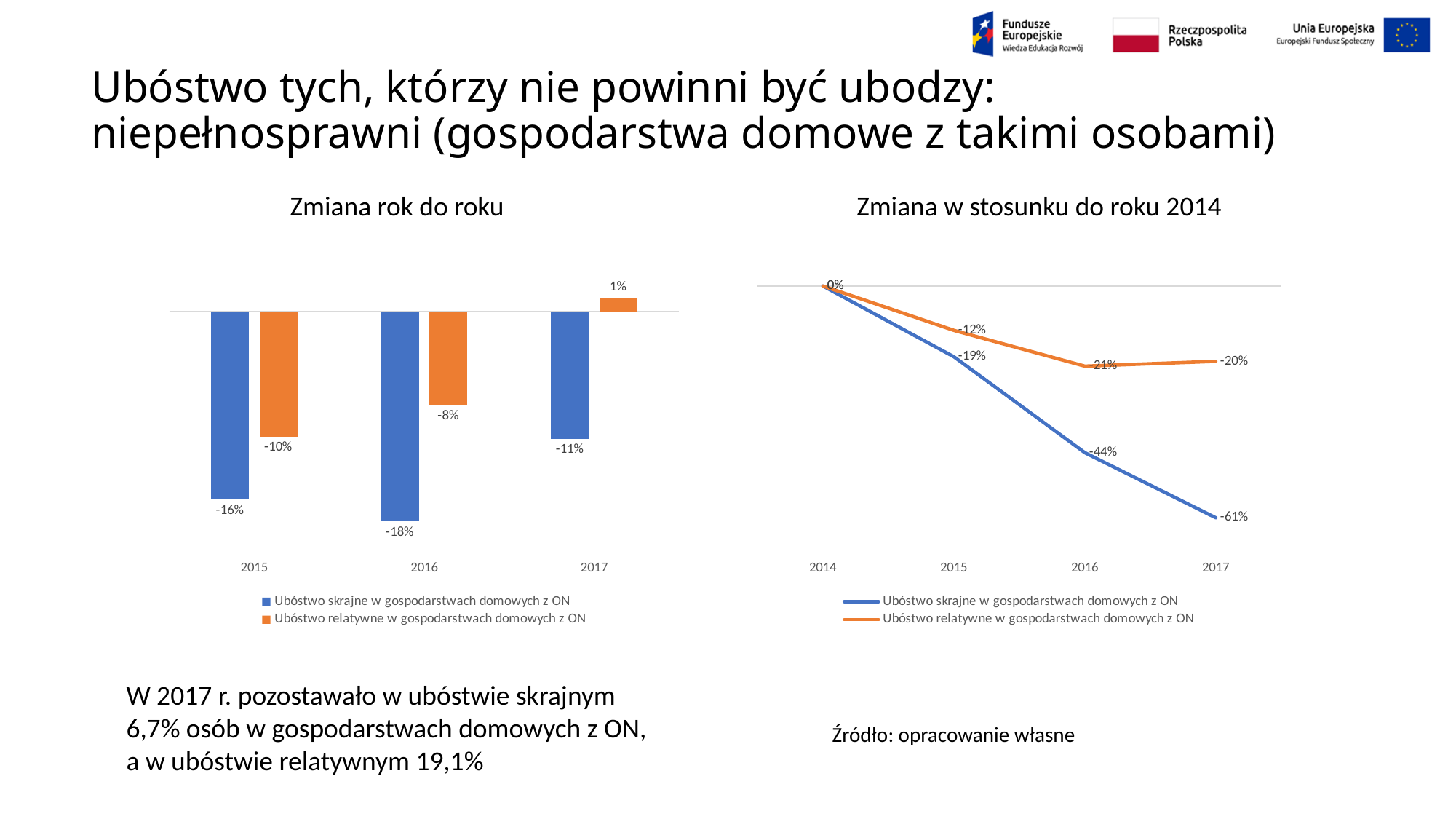
In the chart titled "Zmiana rok do roku", in which year is the value for Ubóstwo skrajne w gospodarstwach domowych z ON lowest? 2016 In the chart titled "Zmiana rok do roku", what is the value for Ubóstwo skrajne w gospodarstwach domowych z ON in 2016? -18% In the chart titled "Zmiana w stosunku do roku 2014", does the Ubóstwo skrajne series rise or fall from 2014 to 2017? Fall What kind of chart is the chart titled "Zmiana w stosunku do roku 2014"? Line chart In the chart titled "Zmiana rok do roku", how many years are shown on the x axis? 3 What kind of chart is the chart titled "Zmiana rok do roku"? Bar chart In the chart titled "Zmiana w stosunku do roku 2014", how many series does the legend list? 2 In the chart titled "Zmiana w stosunku do roku 2014", what is the value for Ubóstwo relatywne w gospodarstwach domowych z ON in 2016? -21% In the chart titled "Zmiana w stosunku do roku 2014", which series has the lower value in 2016, Ubóstwo skrajne or Ubóstwo relatywne? Ubóstwo skrajne w gospodarstwach domowych z ON In the chart titled "Zmiana rok do roku", what is the difference between the Ubóstwo skrajne and Ubóstwo relatywne values in 2015? 6 percentage points In the chart titled "Zmiana w stosunku do roku 2014", what is the value for Ubóstwo skrajne w gospodarstwach domowych z ON in 2017? -61% In the chart titled "Zmiana rok do roku", what is the value for Ubóstwo relatywne w gospodarstwach domowych z ON in 2017? 1%